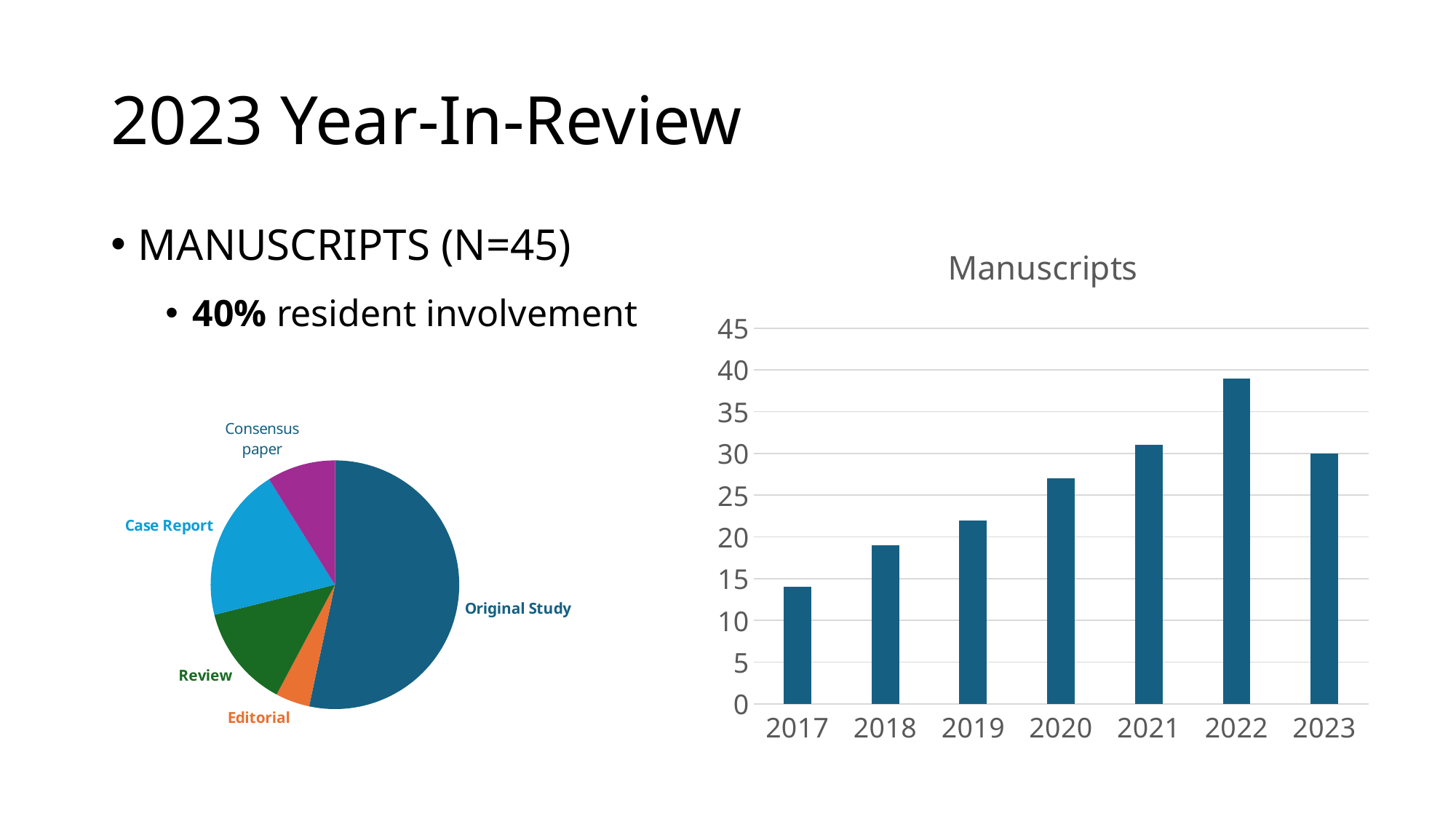
What kind of chart is the chart titled "Manuscripts" on the right of the slide? bar chart What kind of chart is the chart on the left of the slide showing manuscript types? pie chart In the "Manuscripts" bar chart, how many years are shown on the x axis? 7 In the "Manuscripts" bar chart, which year has the lowest value? 2017 In the "Manuscripts" bar chart, do the values rise or fall from 2017 to 2022? rise In the "Manuscripts" bar chart, which year has the highest value? 2022 How many slices does the pie chart on the left of the slide have? 5 In the "Manuscripts" bar chart, is the value for 2017 greater or less than 15? less In the "Manuscripts" bar chart, is the value for 2022 greater or less than 35? greater In the pie chart on the left of the slide, which category has the largest slice? Original Study In the pie chart on the left of the slide, which category has the smallest slice? Editorial In the "Manuscripts" bar chart, which is larger, the value for 2020 or the value for 2023? 2023